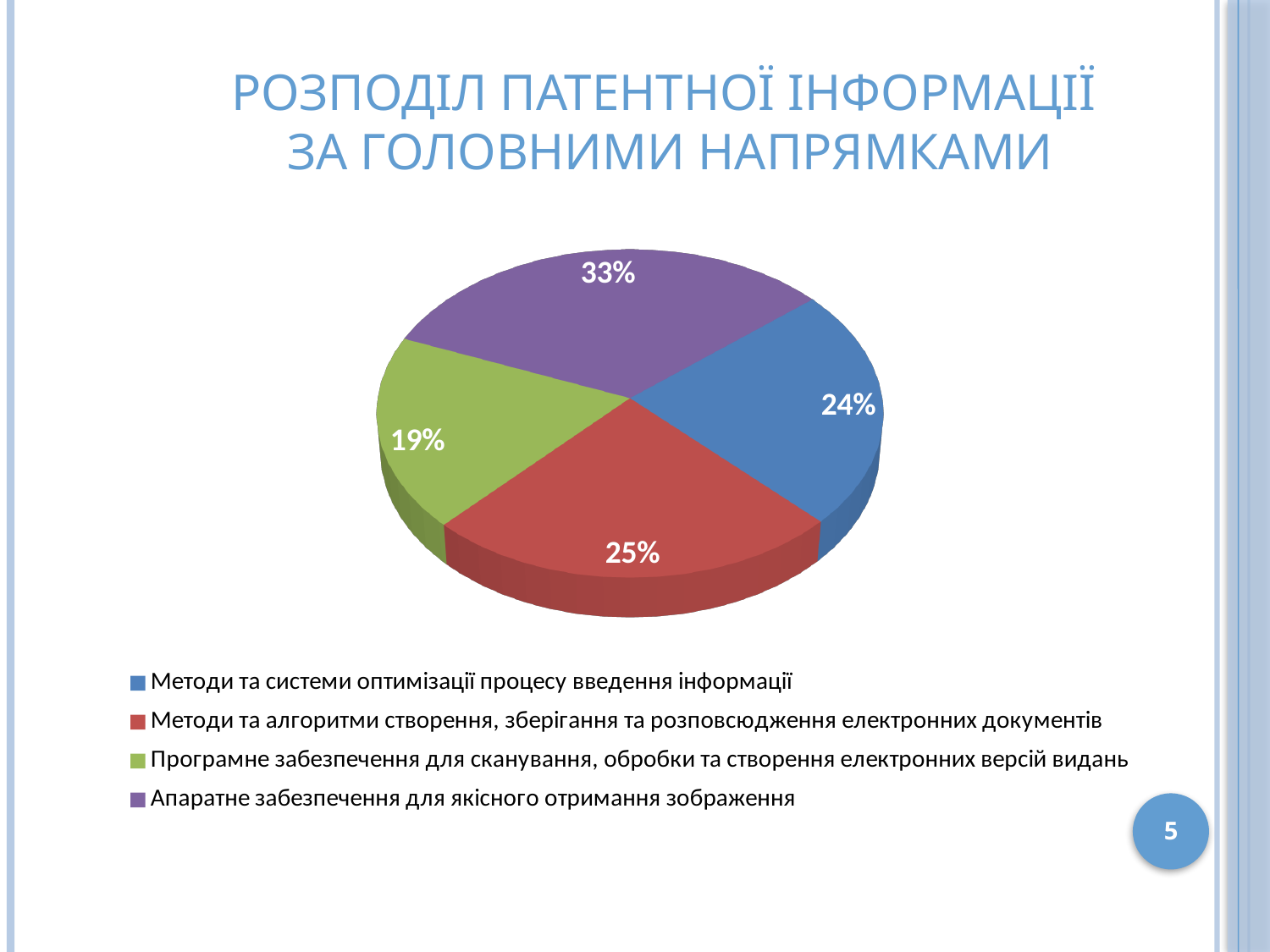
What is the title of the slide containing the chart? Розподіл патентної інформації за головними напрямками Which category has the largest share of the pie? Апаратне забезпечення для якісного отримання зображення What is the share for "Методи та алгоритми створення, зберігання та розповсюдження електронних документів"? 25% How many categories does the pie chart have? 4 Which category has the smallest share of the pie? Програмне забезпечення для сканування, обробки та створення електронних версій видань What is the share for "Методи та системи оптимізації процесу введення інформації"? 24% What kind of chart is shown on the slide? Pie chart What is the share for "Програмне забезпечення для сканування, обробки та створення електронних версій видань"? 19% Which is larger: the share for "Апаратне забезпечення для якісного отримання зображення" or for "Програмне забезпечення для сканування, обробки та створення електронних версій видань"? Апаратне забезпечення для якісного отримання зображення What colour is the slice representing "Методи та алгоритми створення, зберігання та розповсюдження електронних документів"? Red What is the share for "Апаратне забезпечення для якісного отримання зображення"? 33% What is the difference in percentage points between the largest and smallest slices? 14